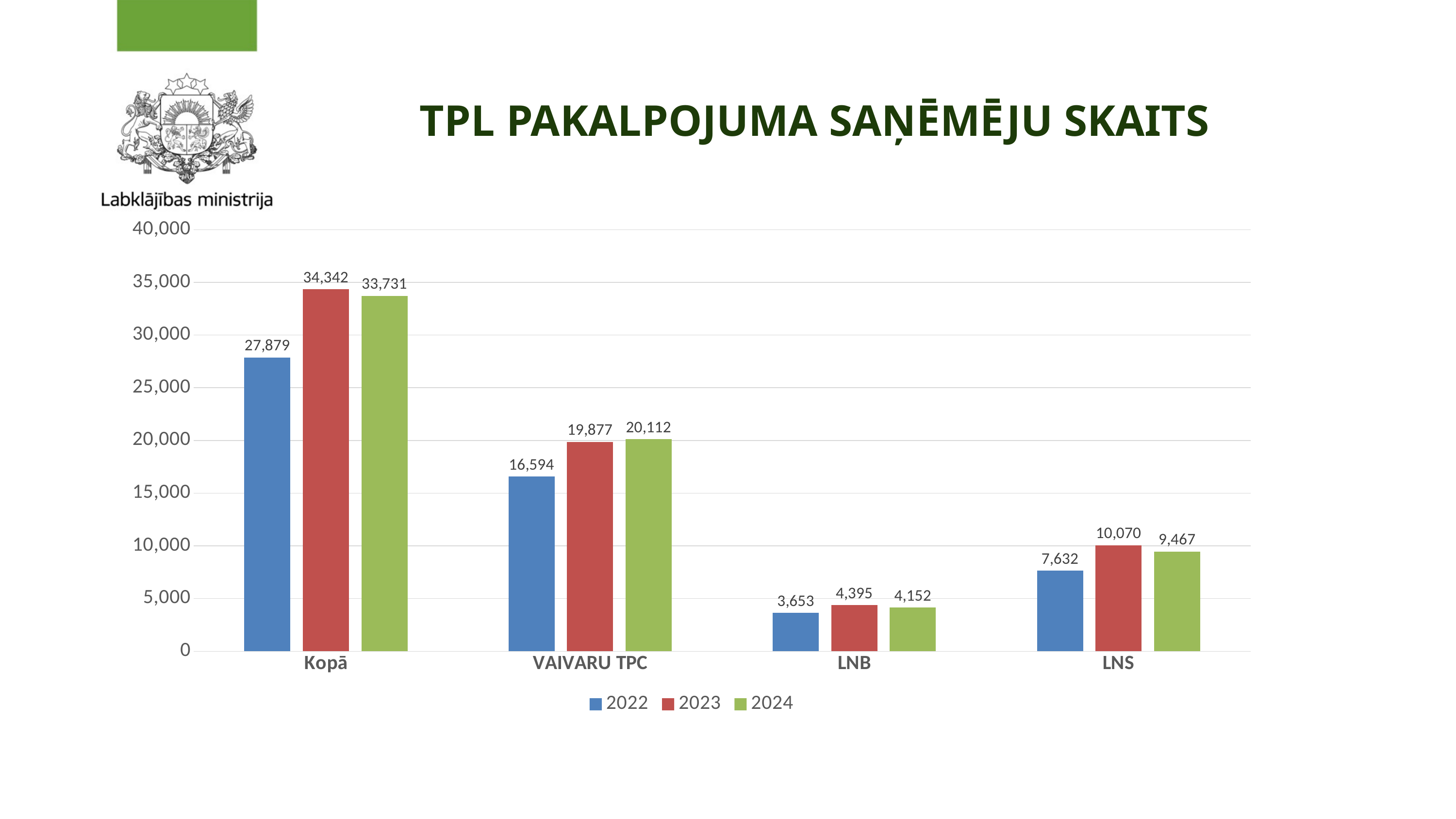
Which year has the highest value for Kopā? 2023 How many categories are shown on the x axis? 4 What is the difference between the 2023 and 2024 values for LNS? 603 What is the value for VAIVARU TPC in 2024? 20,112 Which category has the lowest value in 2024? LNB What is the value for Kopā in 2022? 27,879 How many series does the legend list? 3 What kind of chart is shown on the slide? Bar chart What is the value for LNS in 2022? 7,632 What is the value for LNB in 2023? 4,395 Which is larger for VAIVARU TPC: the 2022 value or the 2023 value? 2023 What is the difference between the 2023 and 2022 values for Kopā? 6,463